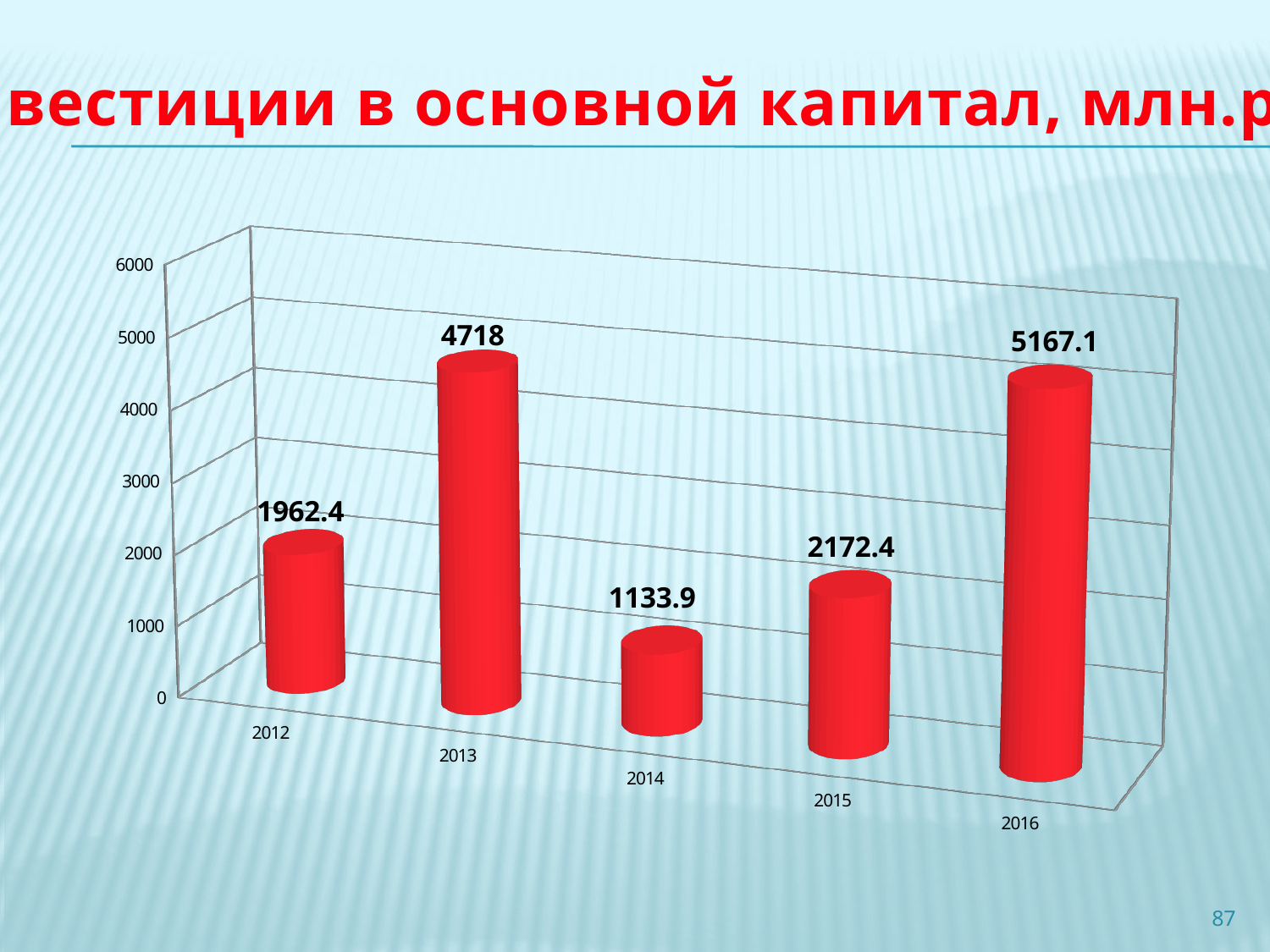
Is the value for 2013 greater or less than 4000? greater What kind of chart is shown on the slide? bar chart What is the value for 2014? 1133.9 How many years are shown on the chart? 5 Which is larger, the value for 2012 or the value for 2015? 2015 What colour are the bars on the chart? red What is the value for 2012? 1962.4 What is the value for 2016? 5167.1 Which year has the lowest value? 2014 What is the difference between the values for 2016 and 2013? 449.1 What is the difference between the values for 2015 and 2014? 1038.5 Which year has the highest value? 2016